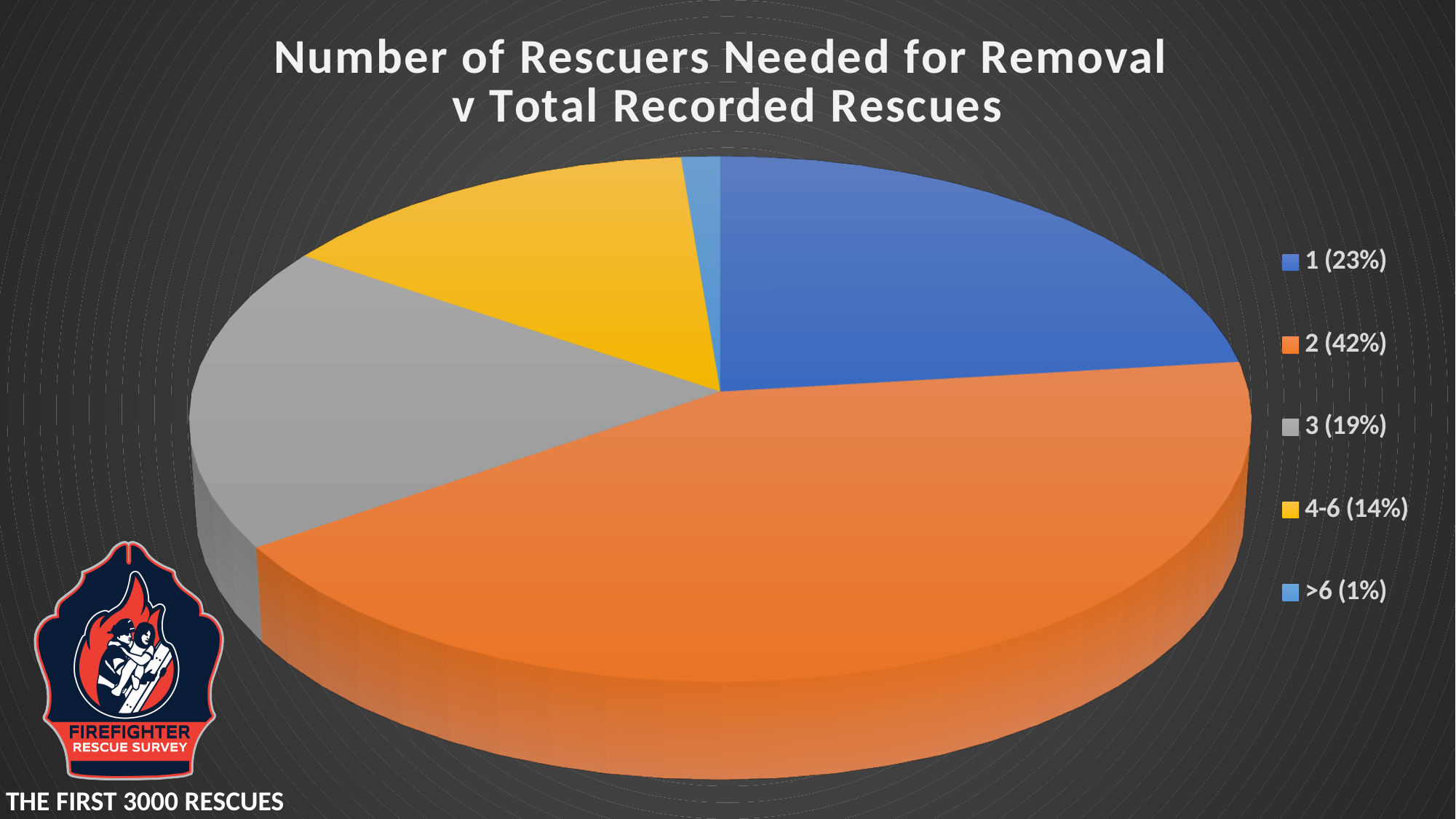
What share of rescues needed more than 6 rescuers? 1% How many slices does the pie chart have? 5 Which is larger, the share for 3 rescuers or the share for 4-6 rescuers? 3 Which category has the smallest share of the pie? >6 Which category has the largest share of the pie? 2 What share of rescues needed 3 rescuers? 19% What share of rescues needed 1 rescuer? 23% What is the title of the chart? Number of Rescuers Needed for Removal v Total Recorded Rescues What kind of chart is shown on the slide? pie chart What is the difference in percentage points between the share for 2 rescuers and the share for 1 rescuer? 19